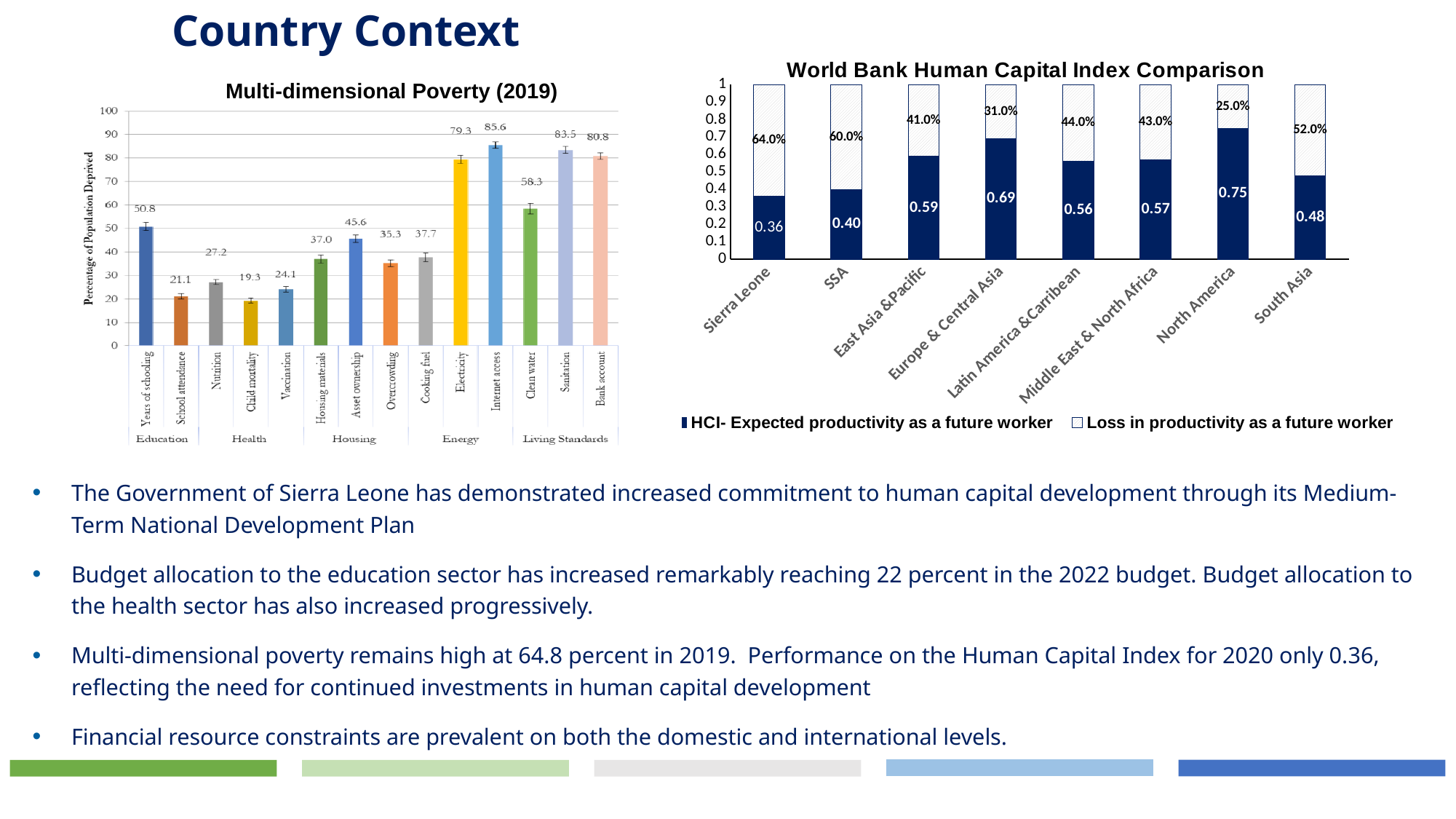
In the Multi-dimensional Poverty (2019) chart, which category has the highest percentage of population deprived? Internet access In the World Bank Human Capital Index Comparison chart, what is the loss in productivity percentage shown for South Asia? 52.0% In the World Bank Human Capital Index Comparison chart, what is the difference between the HCI values for Europe & Central Asia and SSA? 0.29 In the World Bank Human Capital Index Comparison chart, how many series does the legend list? 2 In the Multi-dimensional Poverty (2019) chart, which category has the lowest percentage of population deprived? Child mortality In the Multi-dimensional Poverty (2019) chart, what is the value for Internet access? 85.6 In the Multi-dimensional Poverty (2019) chart, what is the difference between the values for Sanitation and Clean water? 25.2 What kind of chart is the World Bank Human Capital Index Comparison chart? Stacked bar chart In the Multi-dimensional Poverty (2019) chart, how many categories are plotted? 14 In the Multi-dimensional Poverty (2019) chart, which is larger, the value for Years of schooling or the value for Asset ownership? Years of schooling In the World Bank Human Capital Index Comparison chart, what is the HCI value for Sierra Leone? 0.36 In the World Bank Human Capital Index Comparison chart, which region has the highest HCI value? North America